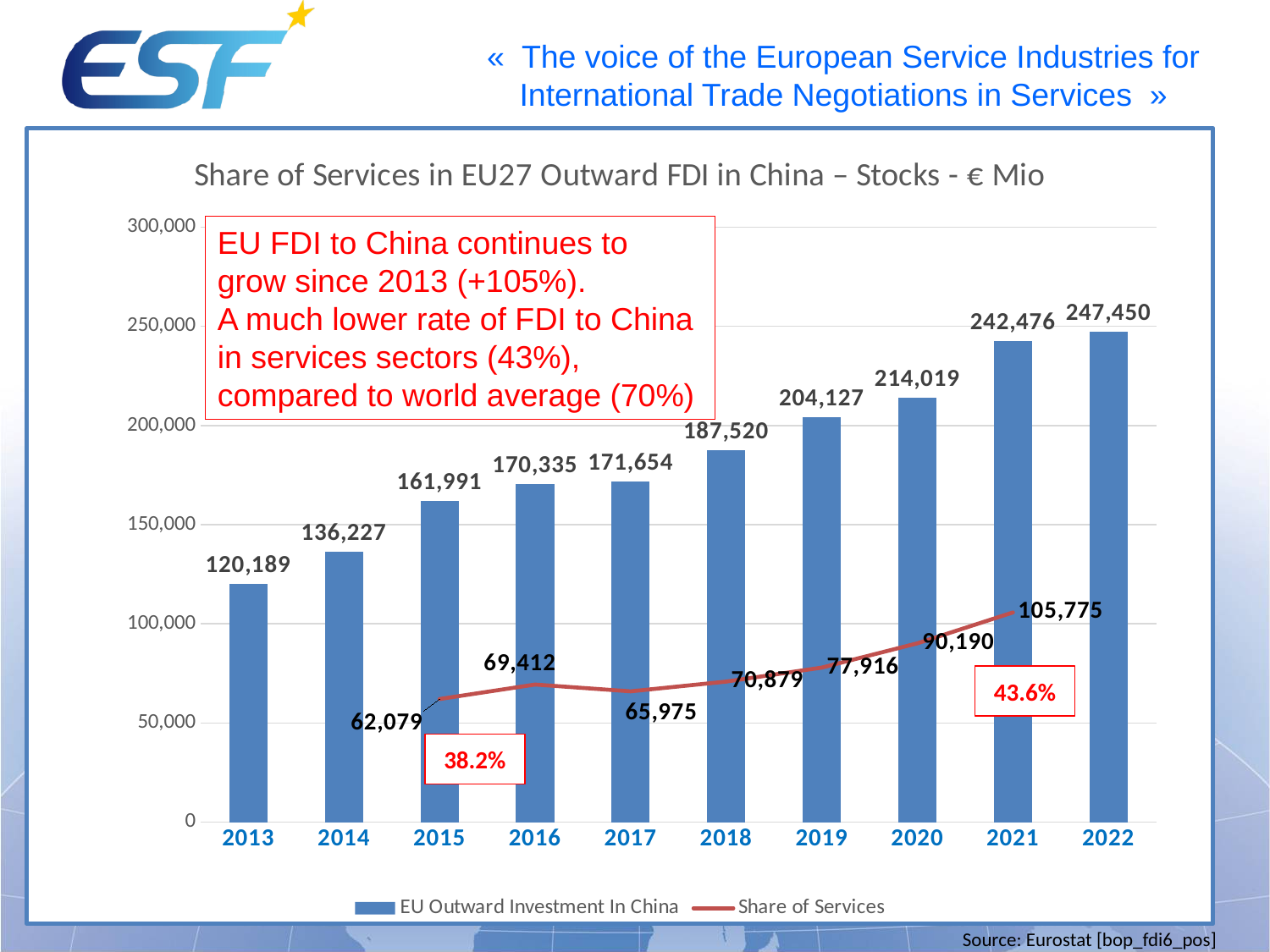
Is the EU Outward Investment In China bar for 2018 greater or less than 200,000? less Which is larger, EU Outward Investment In China in 2019 or in 2020? 2020 What kind of chart is shown on the slide? A bar chart with a line series How many years are shown on the x axis? 10 What is the difference between EU Outward Investment In China in 2022 and in 2013? 127,261 Which year has the lowest EU Outward Investment In China? 2013 How many series does the legend list? 2 What is the value of EU Outward Investment In China for 2013? 120,189 What is the value of the Share of Services line at 2021? 105,775 What is the value of EU Outward Investment In China for 2022? 247,450 Do the EU Outward Investment In China bars rise or fall from 2013 to 2022? rise Which year has the highest EU Outward Investment In China? 2022